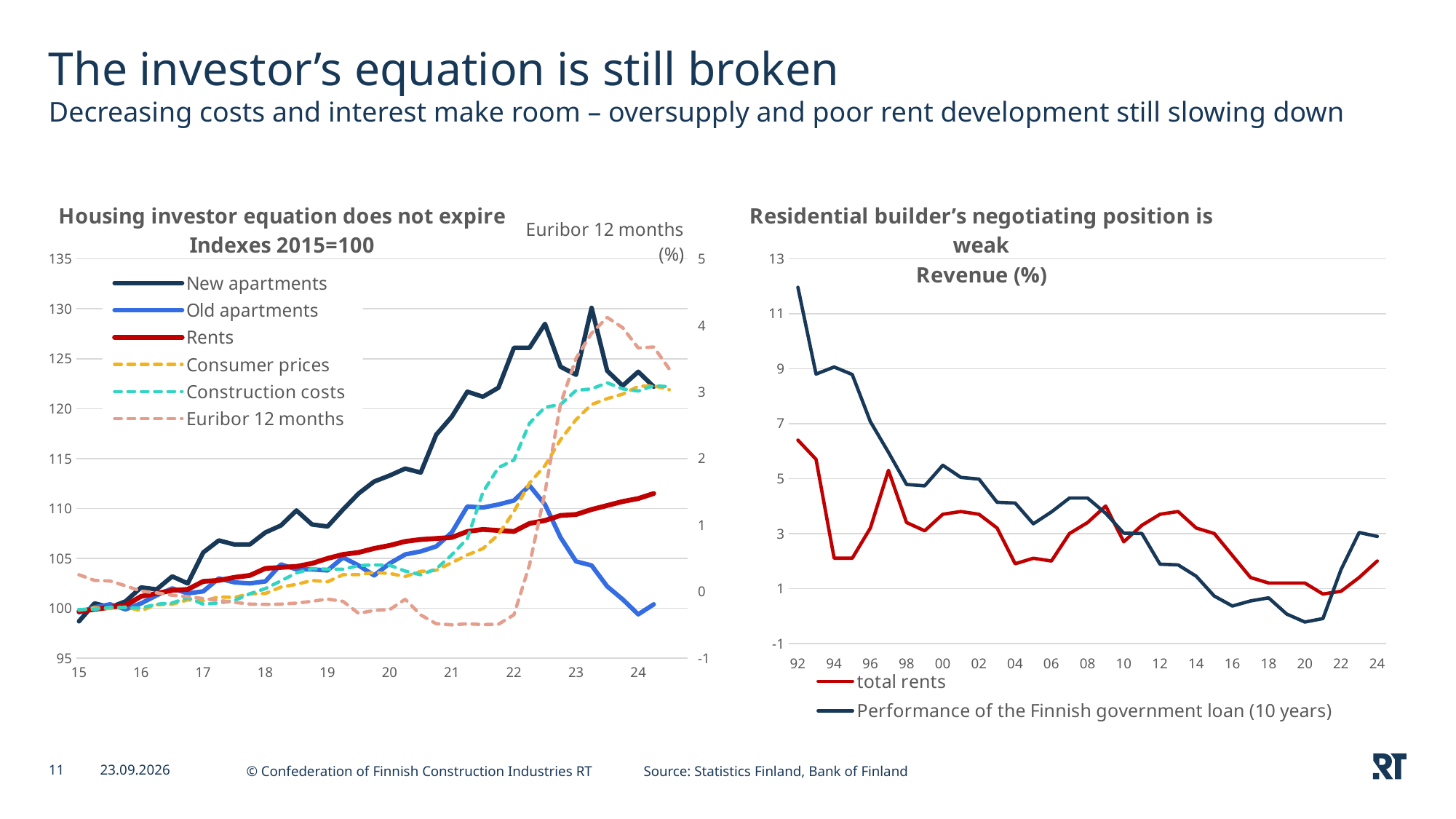
In the right chart "Residential builder's negotiating position is weak", is the value of Performance of the Finnish government loan (10 years) at 92 greater or less than 11? greater How many series does the legend of the left chart "Housing investor equation does not expire" list? 6 In the right chart "Residential builder's negotiating position is weak", does the Performance of the Finnish government loan (10 years) generally rise or fall from 92 to 20? fall In the right chart "Residential builder's negotiating position is weak", which series reaches the highest value on the chart? Performance of the Finnish government loan (10 years) In the left chart "Housing investor equation does not expire", is the peak value of New apartments in 2023 greater or less than 125? greater In the left chart "Housing investor equation does not expire", is the value of Old apartments at 24 greater or less than 105? less What kind of chart is the left chart titled "Housing investor equation does not expire"? Line chart How many series does the legend of the right chart "Residential builder's negotiating position is weak" list? 2 What is the label of the secondary (right-hand) axis on the left chart "Housing investor equation does not expire"? Euribor 12 months (%) In the left chart "Housing investor equation does not expire", which is higher at 24: New apartments or Old apartments? New apartments